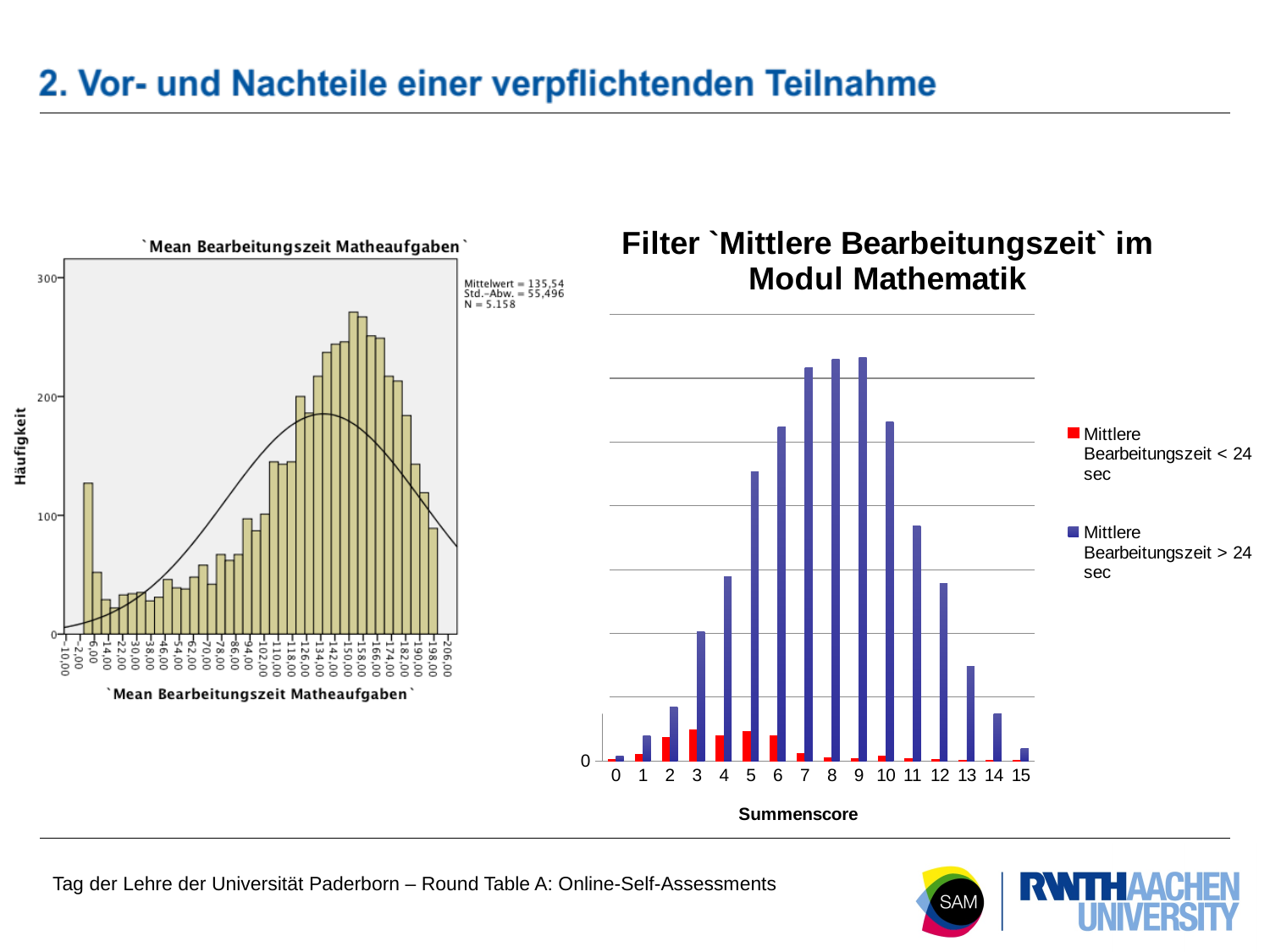
In the chart 'Filter `Mittlere Bearbeitungszeit` im Modul Mathematik', for the series 'Mittlere Bearbeitungszeit > 24 sec', is the value at Summenscore 12 larger or smaller than at Summenscore 10? smaller In the chart 'Filter `Mittlere Bearbeitungszeit` im Modul Mathematik', do the values of the series 'Mittlere Bearbeitungszeit > 24 sec' rise or fall from Summenscore 9 to Summenscore 15? fall In the chart 'Filter `Mittlere Bearbeitungszeit` im Modul Mathematik', for the series 'Mittlere Bearbeitungszeit > 24 sec', is the value at Summenscore 7 larger or smaller than at Summenscore 3? larger In the left chart titled '`Mean Bearbeitungszeit Matheaufgaben`', what is the Mittelwert printed on the chart? 135,54 How many series does the legend of the chart 'Filter `Mittlere Bearbeitungszeit` im Modul Mathematik' list? 2 What is the x-axis label of the chart 'Filter `Mittlere Bearbeitungszeit` im Modul Mathematik'? Summenscore In the left chart titled '`Mean Bearbeitungszeit Matheaufgaben`', what is the value of N printed on the chart? 5.158 In the chart 'Filter `Mittlere Bearbeitungszeit` im Modul Mathematik', which series is shown in red? Mittlere Bearbeitungszeit < 24 sec How many Summenscore categories are shown on the x axis of the chart 'Filter `Mittlere Bearbeitungszeit` im Modul Mathematik'? 16 In the chart 'Filter `Mittlere Bearbeitungszeit` im Modul Mathematik', for the series 'Mittlere Bearbeitungszeit > 24 sec', which Summenscore has the lowest value? 0 In the left chart titled '`Mean Bearbeitungszeit Matheaufgaben`', is the Häufigkeit for the bar at 150,00 greater or less than 200? greater What kind of chart is the chart titled 'Filter `Mittlere Bearbeitungszeit` im Modul Mathematik'? bar chart